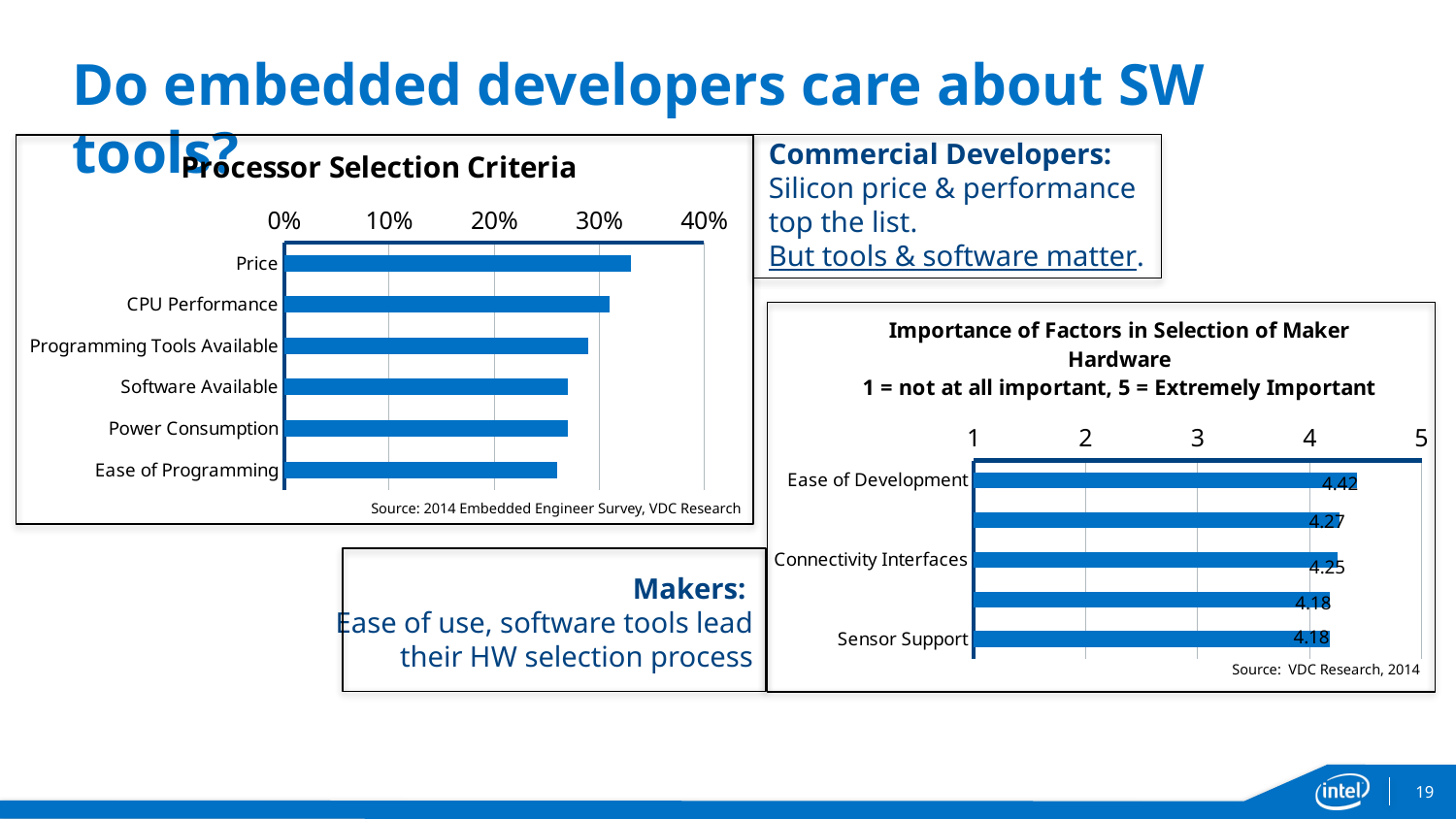
In the 'Importance of Factors in Selection of Maker Hardware' chart, what is the value for Sensor Support? 4.18 In the 'Importance of Factors in Selection of Maker Hardware' chart, which factor has the highest value? Ease of Development How many categories are shown in the 'Processor Selection Criteria' chart? 6 In the 'Processor Selection Criteria' chart, is the value for Ease of Programming greater or less than 30%? less In the 'Importance of Factors in Selection of Maker Hardware' chart, what is the value for Connectivity Interfaces? 4.25 What source is cited for the 'Processor Selection Criteria' chart? 2014 Embedded Engineer Survey, VDC Research In the 'Processor Selection Criteria' chart, which is larger: Price or Ease of Programming? Price In the 'Importance of Factors in Selection of Maker Hardware' chart, what is the difference between Ease of Development and Sensor Support? 0.24 In the 'Processor Selection Criteria' chart, is the value for Price greater or less than 30%? greater In the 'Processor Selection Criteria' chart, which category has the highest value? Price What kind of chart is the 'Processor Selection Criteria' chart? bar chart In the 'Importance of Factors in Selection of Maker Hardware' chart, what is the value for Ease of Development? 4.42